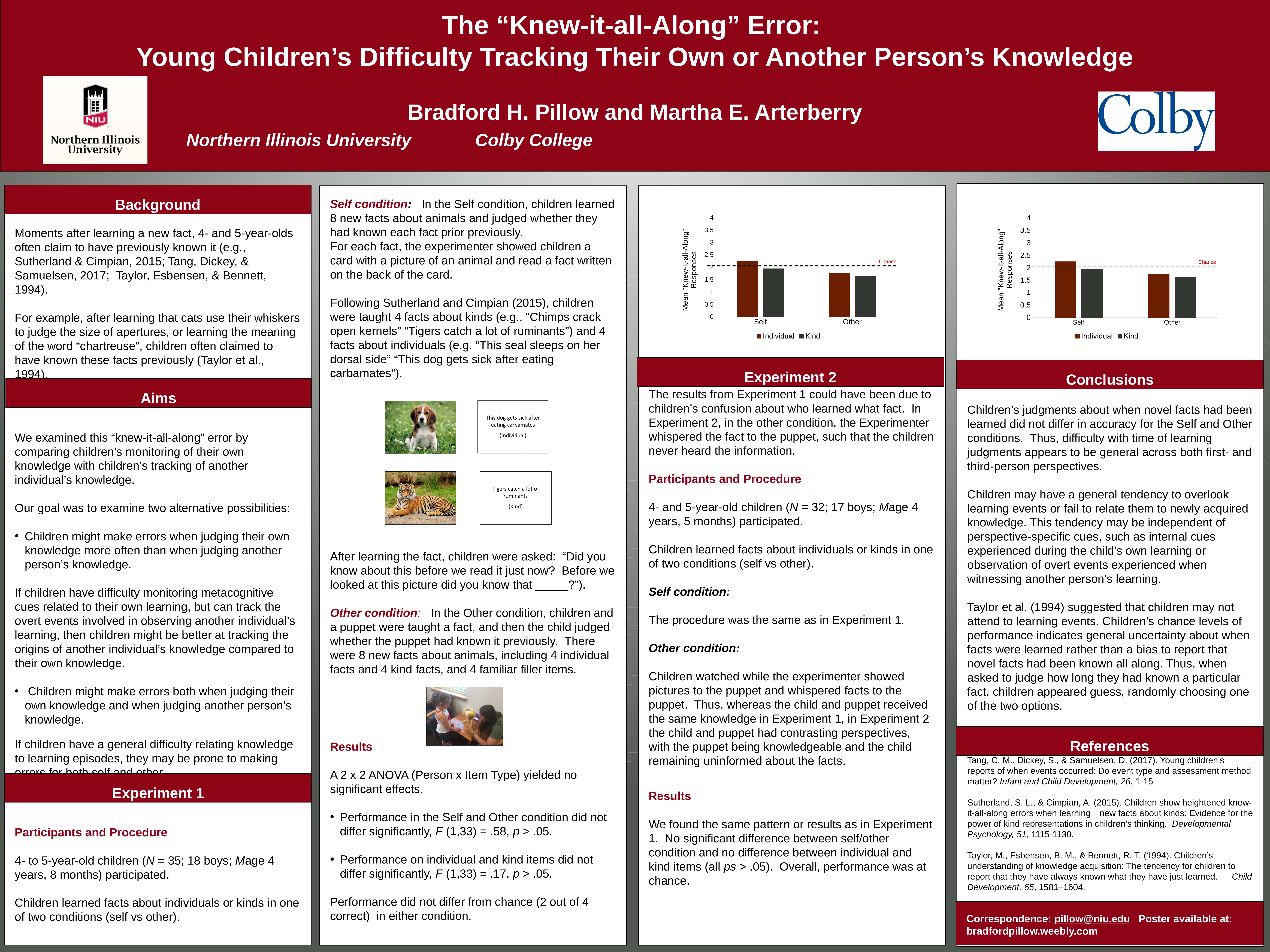
What does the dashed horizontal line in the left chart (above Experiment 2) represent? Chance How many series does the legend of the left chart (above Experiment 2) list? 2 In the left chart (above Experiment 2), is the Individual value for Self greater or less than 2? greater What type of chart is the right chart (above the Conclusions section)? bar chart In the left chart (above Experiment 2), which bar is the highest? Individual for Self What are the two legend entries in the right chart (above Conclusions)? Individual and Kind In the left chart (above Experiment 2), is the Individual value for Other greater or less than 2? less In the left chart (above Experiment 2), which is larger: the Individual value for Self or the Individual value for Other? Self What type of chart is the left chart (above the Experiment 2 section)? bar chart What are the two categories on the x axis of the left chart (above Experiment 2)? Self and Other In the right chart (above Conclusions), is the Kind value for Other greater or less than 2? less In the right chart (above Conclusions), which is larger: the Kind value for Self or the Kind value for Other? Self